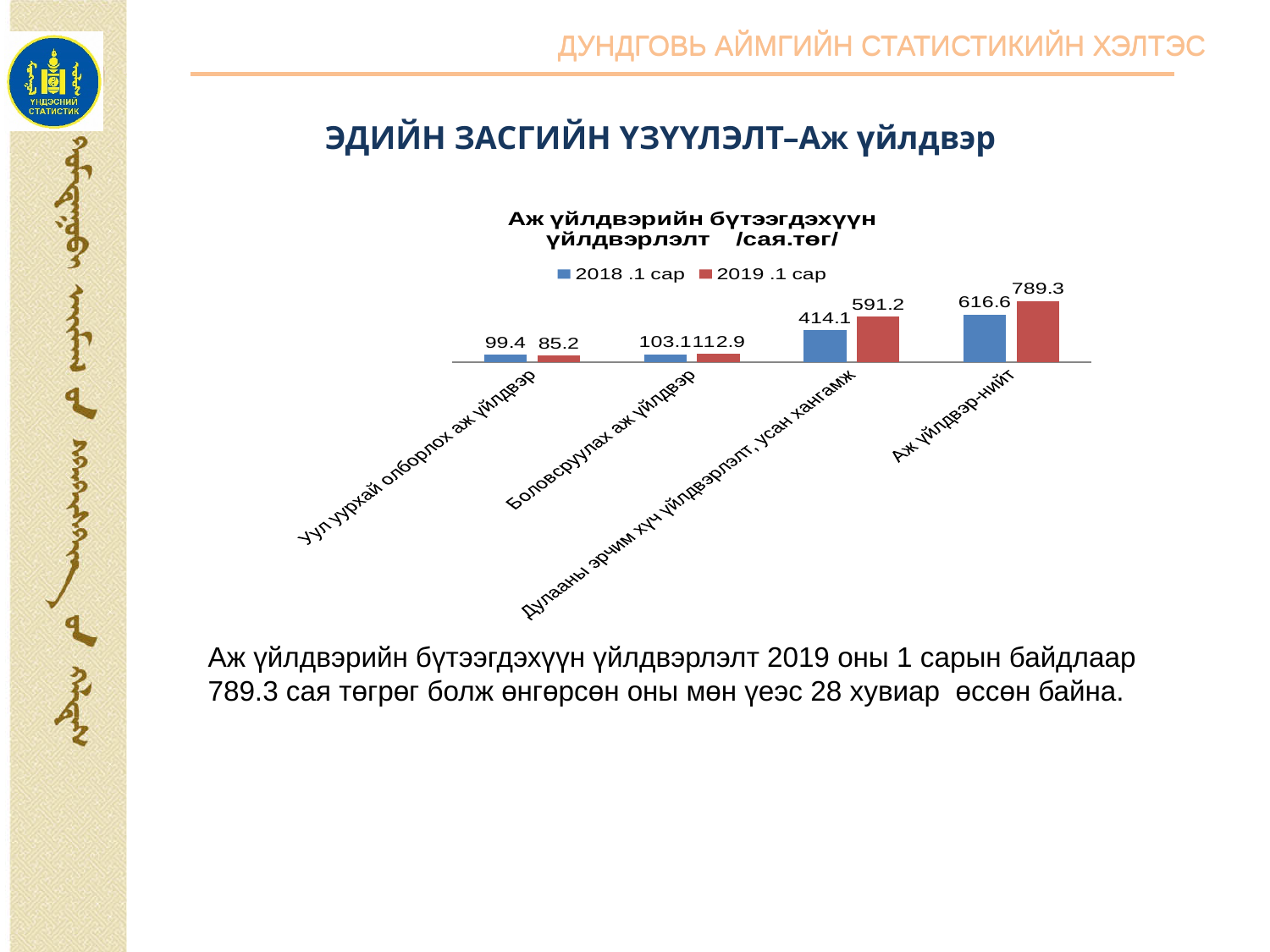
What is the value for Дулааны эрчим хүч үйлдвэрлэлт, усан хангамж in the 2018 .1 сар series? 414.1 For Дулааны эрчим хүч үйлдвэрлэлт, усан хангамж, which series has the larger value: 2018 .1 сар or 2019 .1 сар? 2019 .1 сар Which category has the highest value in the 2019 .1 сар series? Аж үйлдвэр-нийт Which category has the lowest value in the 2019 .1 сар series? Уул уурхай олборлох аж үйлдвэр What is the difference between the 2019 .1 сар and 2018 .1 сар values for Аж үйлдвэр-нийт? 172.7 What is the value for Боловсруулах аж үйлдвэр in the 2019 .1 сар series? 112.9 How many series does the legend list? 2 What type of chart is shown on the slide? Bar chart How many categories are shown on the x axis? 4 What is the value for Аж үйлдвэр-нийт in the 2019 .1 сар series? 789.3 What is the value for Уул уурхай олборлох аж үйлдвэр in the 2018 .1 сар series? 99.4 What colour are the bars for the 2018 .1 сар series? Blue